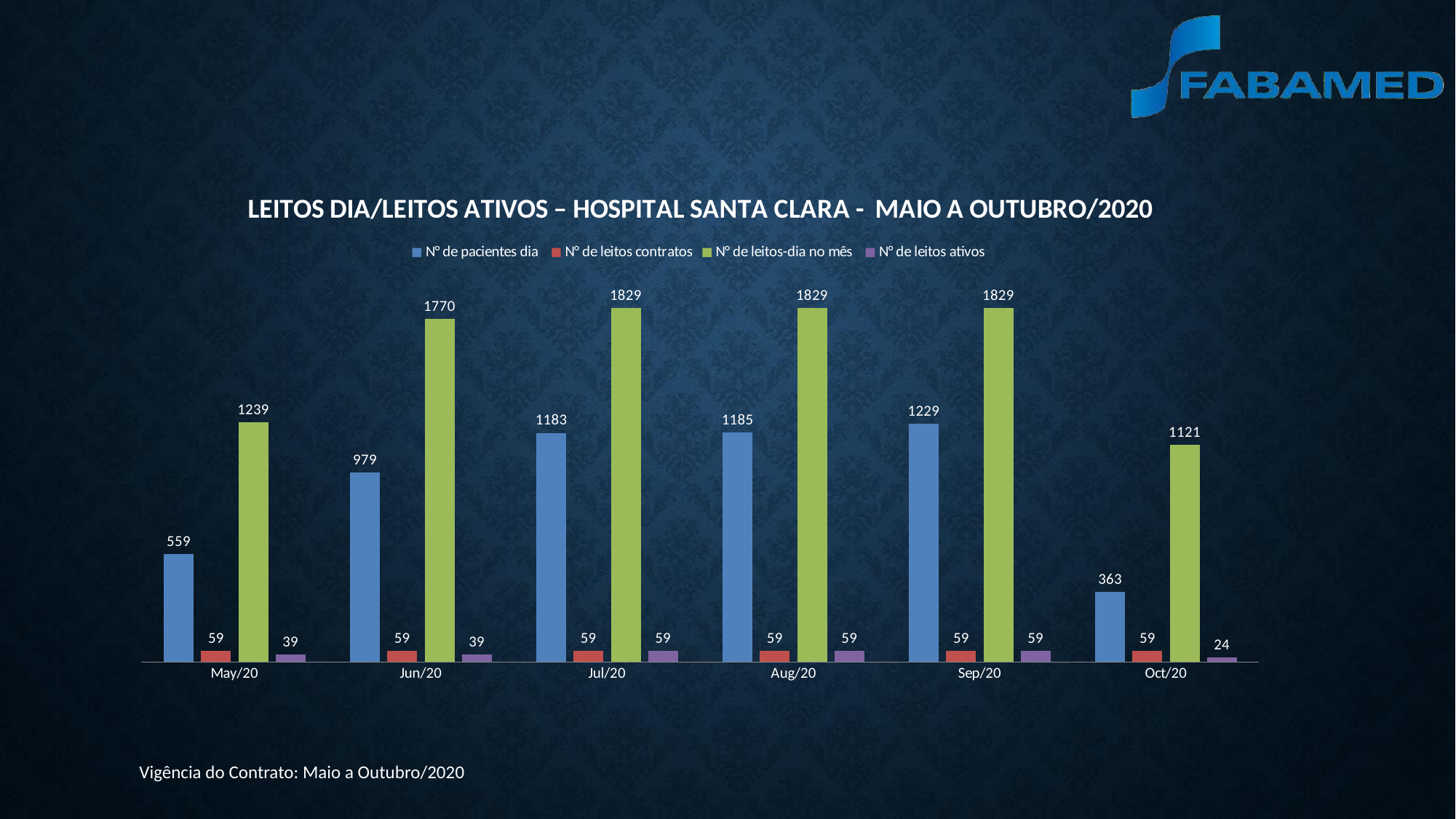
What kind of chart is shown on the slide? Bar chart What is the value of N° de leitos-dia no mês for Jun/20? 1770 What is the value of N° de leitos contratos in Aug/20? 59 Which month has the highest value for N° de pacientes dia? Sep/20 How many months are shown on the x axis? 6 Which is larger in Oct/20: N° de pacientes dia or N° de leitos-dia no mês? N° de leitos-dia no mês What is the value of N° de pacientes dia for Jul/20? 1183 What is the difference between N° de leitos-dia no mês and N° de pacientes dia in May/20? 680 What is the value of N° de leitos ativos for Oct/20? 24 How many series does the legend list? 4 What is the title of the chart? LEITOS DIA/LEITOS ATIVOS – HOSPITAL SANTA CLARA - MAIO A OUTUBRO/2020 Which month has the lowest value for N° de pacientes dia? Oct/20